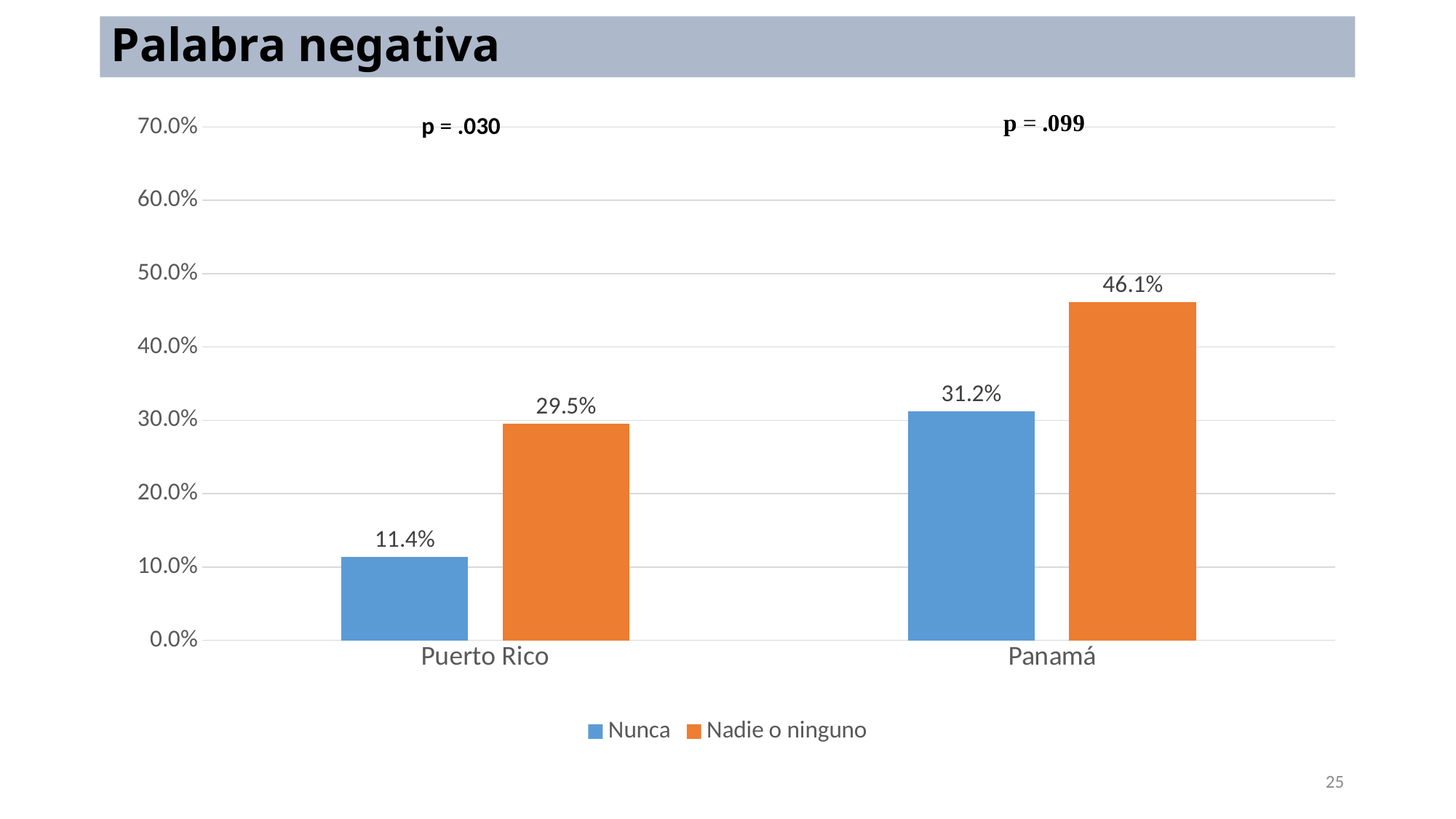
What p-value is shown above the Puerto Rico bars? p = .030 What is the value for Nunca in Puerto Rico? 11.4% How many countries are shown on the x axis? 2 Which is larger, Nunca in Panamá or Nadie o ninguno in Puerto Rico? Nunca in Panamá Which bar has the lowest value on the chart? Nunca in Puerto Rico What kind of chart is shown on the slide? Bar chart What is the difference between Nadie o ninguno and Nunca in Puerto Rico? 18.1% Which bar has the highest value on the chart? Nadie o ninguno in Panamá How many series does the legend list? 2 What is the value for Nadie o ninguno in Panamá? 46.1% What is the value for Nunca in Panamá? 31.2% What is the value for Nadie o ninguno in Puerto Rico? 29.5%